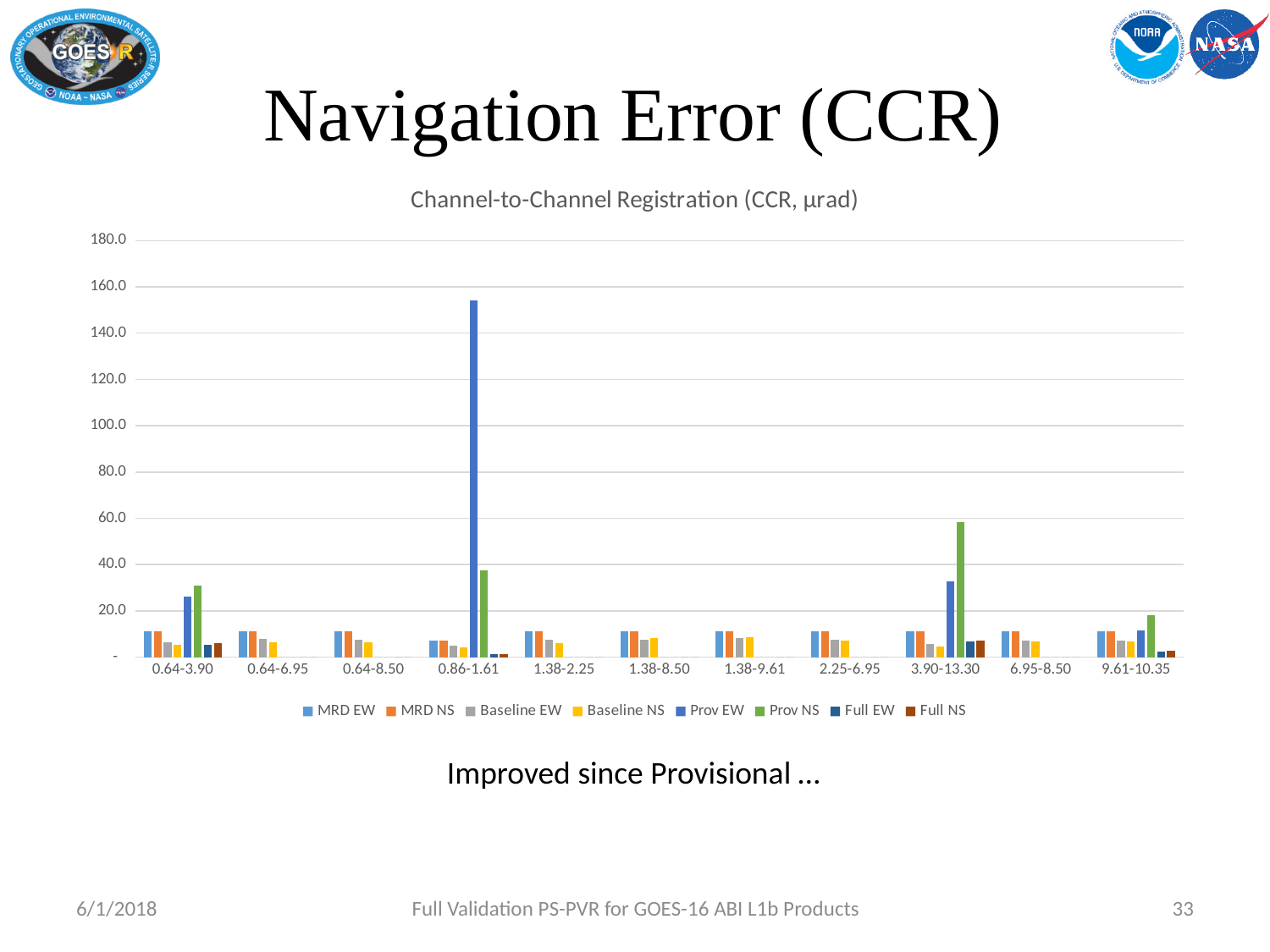
Which category contains the tallest bar in the chart? 0.86-1.61 What kind of chart is shown on the slide? bar chart What is the title of the chart? Channel-to-Channel Registration (CCR, μrad) Is the Prov EW value for 0.86-1.61 greater or less than 140? greater Is the Prov EW value for 3.90-13.30 greater or less than 20? greater Is the Prov NS value for 3.90-13.30 greater or less than 40? greater Which is larger: the Prov EW value for 0.86-1.61 or the Prov NS value for 3.90-13.30? Prov EW value for 0.86-1.61 How many channel-pair categories are shown along the x axis? 11 Which series has the tallest bar in the 0.86-1.61 category? Prov EW Which series is shown in green in the legend? Prov NS How many series does the chart legend list? 8